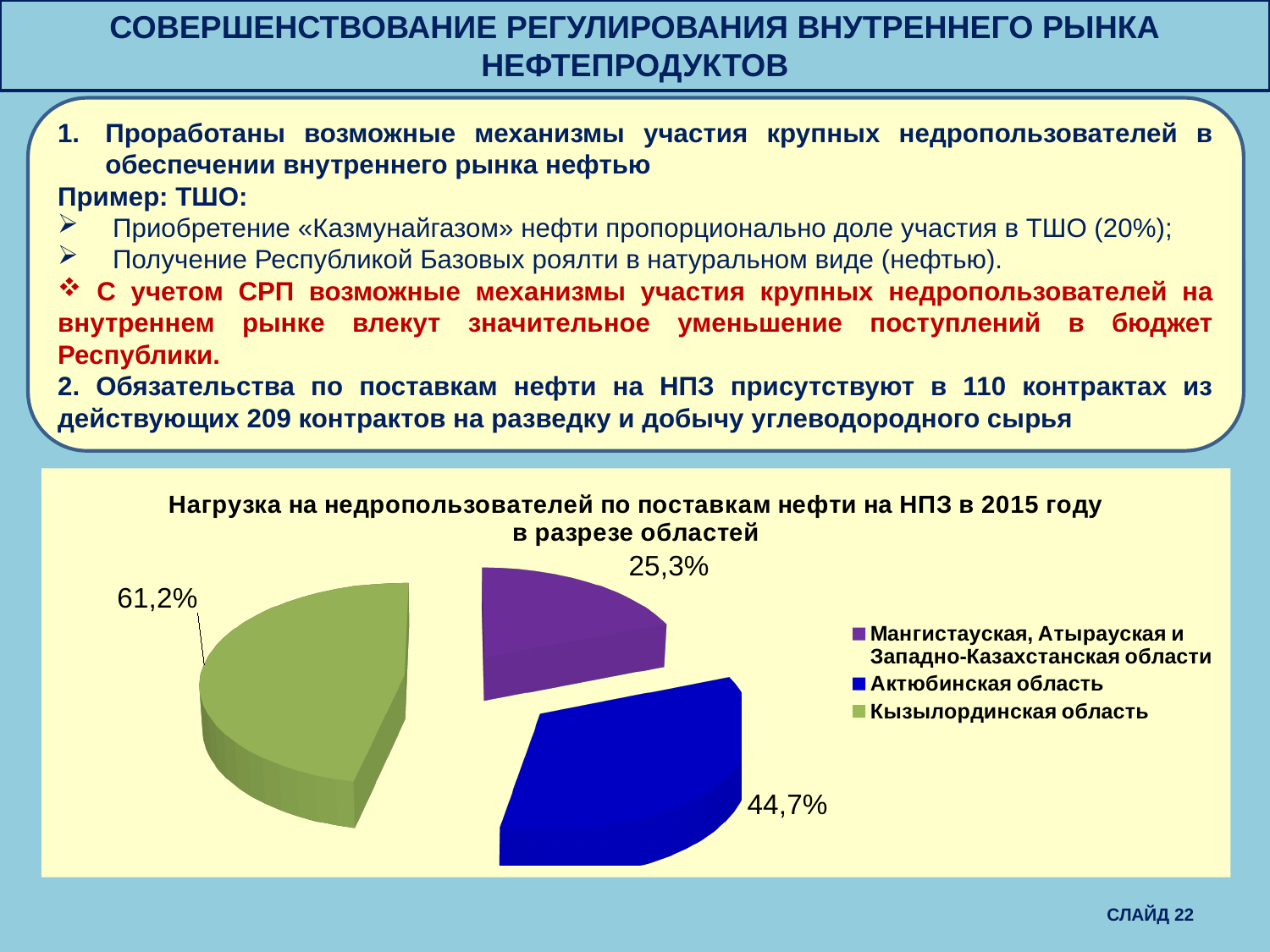
What is the difference between the values for Актюбинская область and Мангистауская, Атырауская и Западно-Казахстанская области? 19,4% Which is larger: the value for Актюбинская область or the value for Мангистауская, Атырауская и Западно-Казахстанская области? Актюбинская область What is the value shown for Мангистауская, Атырауская и Западно-Казахстанская области? 25,3% What is the value shown for Актюбинская область? 44,7% What kind of chart is shown on the slide? Pie chart What is the difference between the values for Кызылординская область and Актюбинская область? 16,5% How many slices does the pie chart have? 3 How many entries does the legend list? 3 Which region has the highest value in the pie chart? Кызылординская область What colour is the slice for Актюбинская область? Blue What is the value shown for Кызылординская область? 61,2% Which legend entry has the lowest value in the pie chart? Мангистауская, Атырауская и Западно-Казахстанская области